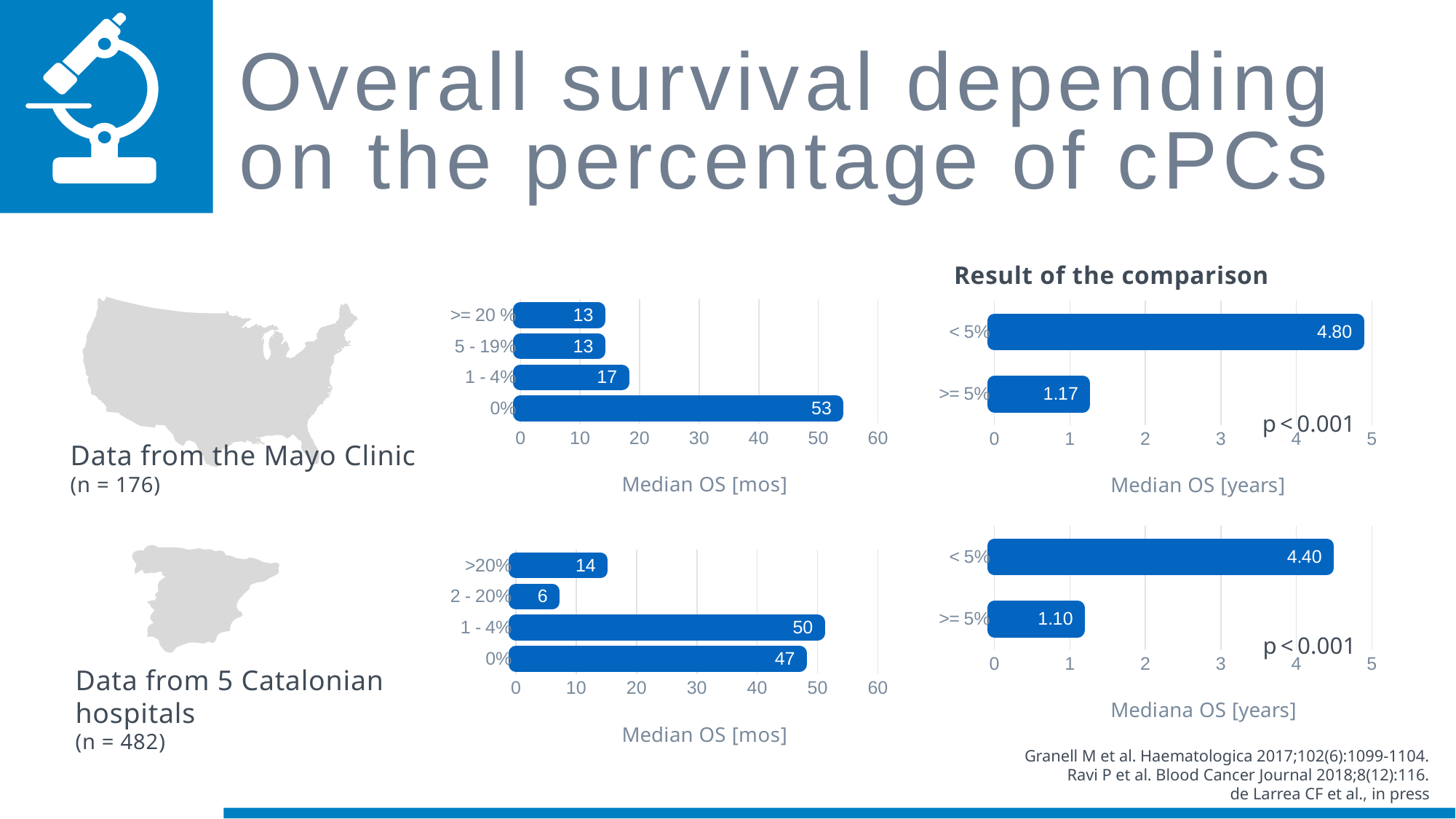
In the bottom-middle chart (Catalonian hospitals, Median OS [mos]), which is larger, the value for 1 - 4% or the value for 0%? 1 - 4% In the bottom-right chart (Catalonian hospitals, Mediana OS [years]), what is the median OS for the >= 5% group? 1.10 In the bottom-middle chart (Catalonian hospitals, Median OS [mos]), which category has the lowest median OS? 2 - 20% In the top-right chart (Mayo Clinic, Median OS [years]), what is the difference between the < 5% and >= 5% values? 3.63 How many categories are shown in the bottom-middle chart (Catalonian hospitals, Median OS [mos])? 4 In the top-right chart (Mayo Clinic, Median OS [years]), what is the median OS for the < 5% group? 4.80 In the bottom-middle chart (Catalonian hospitals, Median OS [mos]), what is the median OS for the 2 - 20% category? 6 In the top-middle chart (Mayo Clinic, Median OS [mos]), what is the median OS for the 1 - 4% category? 17 In the top-middle chart (Mayo Clinic, Median OS [mos]), what is the difference between the 0% and 1 - 4% values? 36 What type of chart is the top-right chart (Median OS [years])? Bar chart In the top-middle chart (Mayo Clinic, Median OS [mos]), which category has the highest median OS? 0% In the top-middle chart (Mayo Clinic, Median OS [mos]), what is the median OS for the 0% category? 53